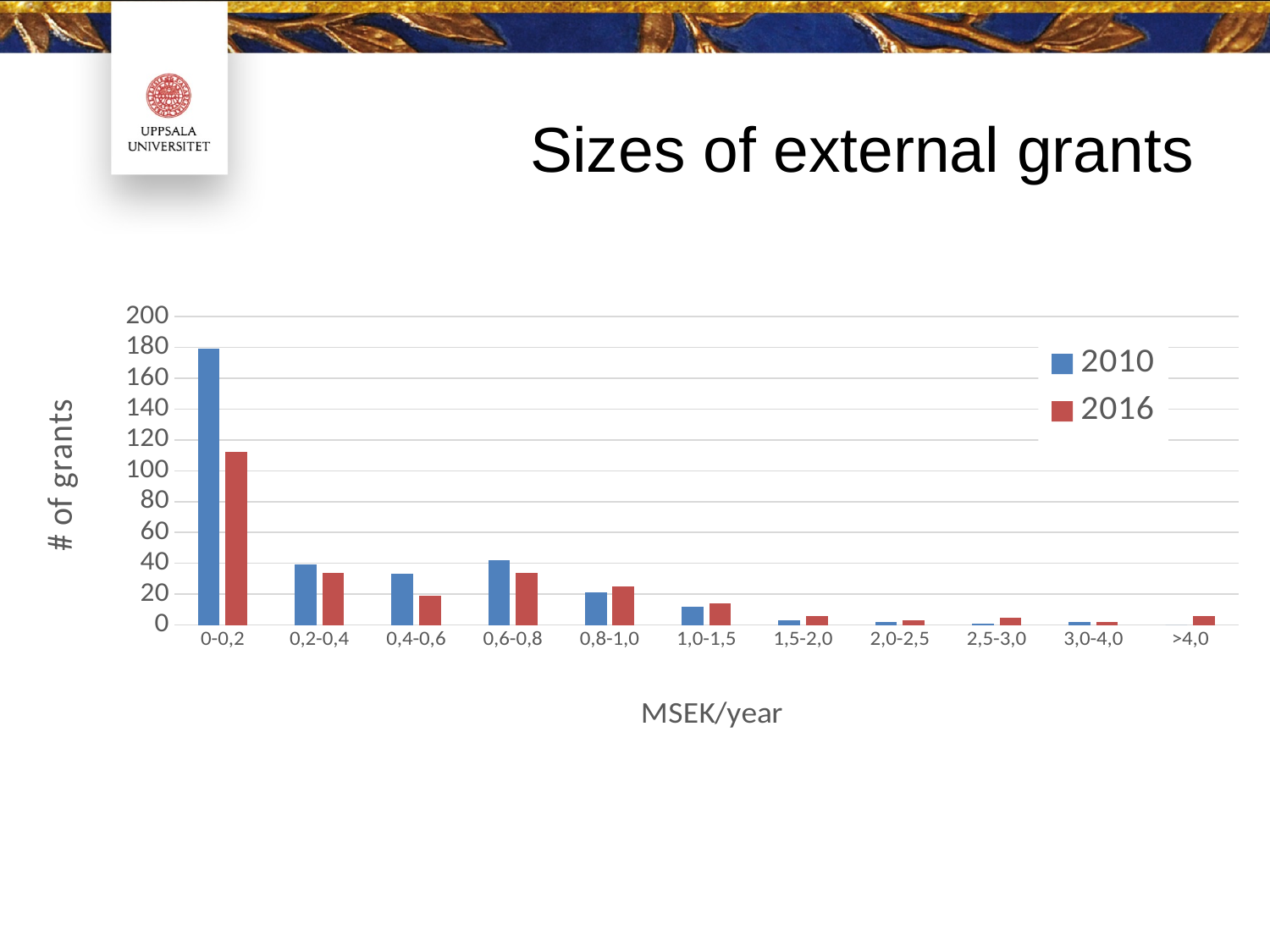
In the 0,4-0,6 category, which year has more grants, 2010 or 2016? 2010 Which grant-size category has the highest number of grants for 2010? 0-0,2 How many series does the legend list? 2 Is the 2010 value for the 0,6-0,8 category greater or less than 60? less In the 0-0,2 category, which year has more grants, 2010 or 2016? 2010 Which grant-size category has the highest number of grants for 2016? 0-0,2 Is the 2010 value for the 0-0,2 category greater or less than 160? greater Is the 2016 value for the 0-0,2 category greater or less than 100? greater What kind of chart is shown on the slide? bar chart What is the label of the x axis? MSEK/year How many grant-size categories are shown on the x axis? 11 Which colour represents the 2016 series? red